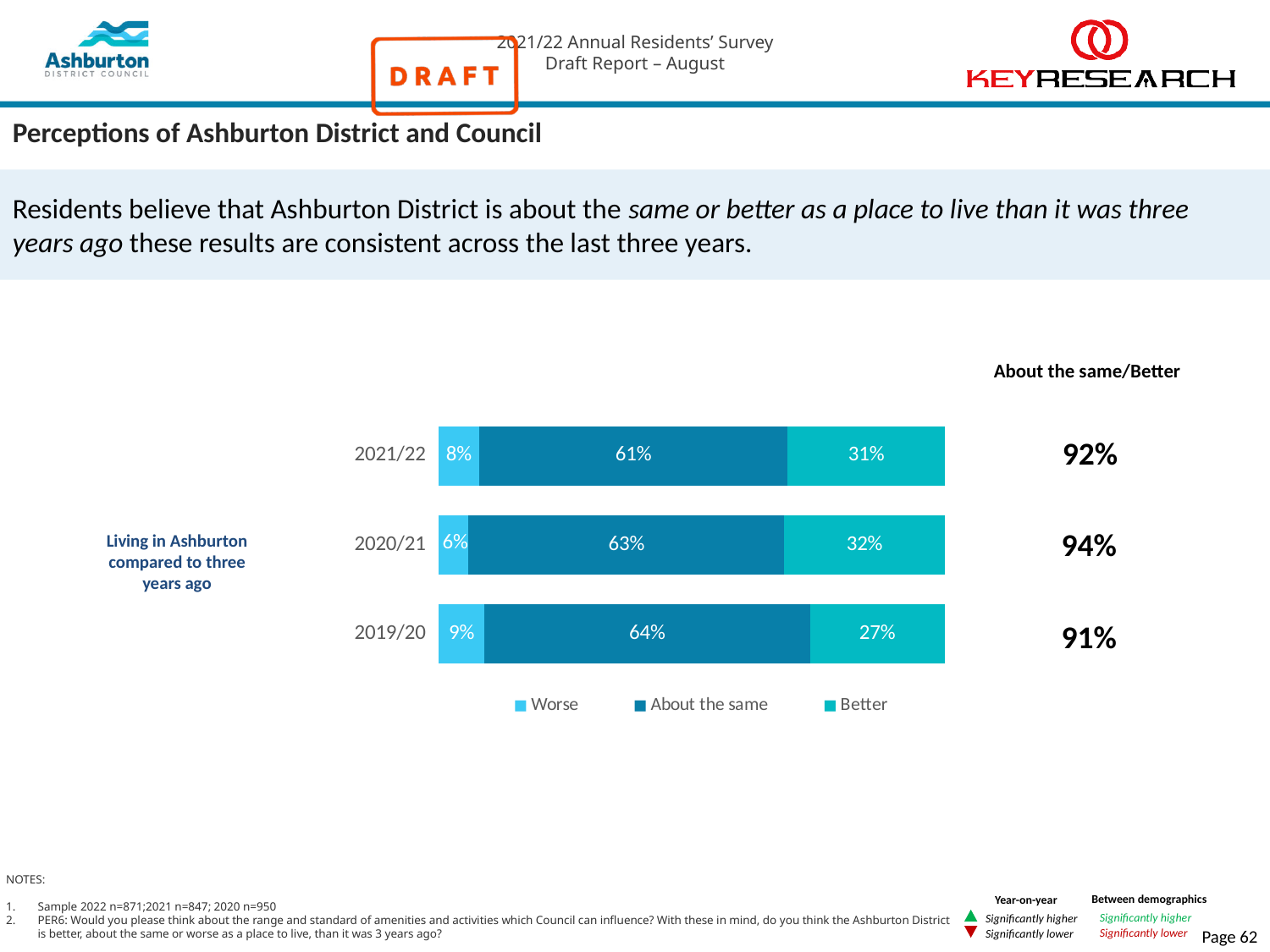
What is the combined 'About the same/Better' percentage shown for 2020/21? 94% What percentage of residents said Ashburton District is 'About the same' as a place to live in 2021/22? 61% Is the 'About the same' percentage larger in 2019/20 or in 2021/22? 2019/20 Which year has the highest 'Worse' percentage? 2019/20 How many series does the legend list? 3 What kind of chart is shown on the slide? Stacked bar chart What is the difference between the 'Better' percentages for 2020/21 and 2019/20? 5% How many years are shown in the chart? 3 What percentage of residents said 'Better' in 2019/20? 27% What percentage of residents said 'Worse' in 2020/21? 6% Which year has the lowest 'Better' percentage? 2019/20 What are the three legend entries in the chart? Worse, About the same, Better